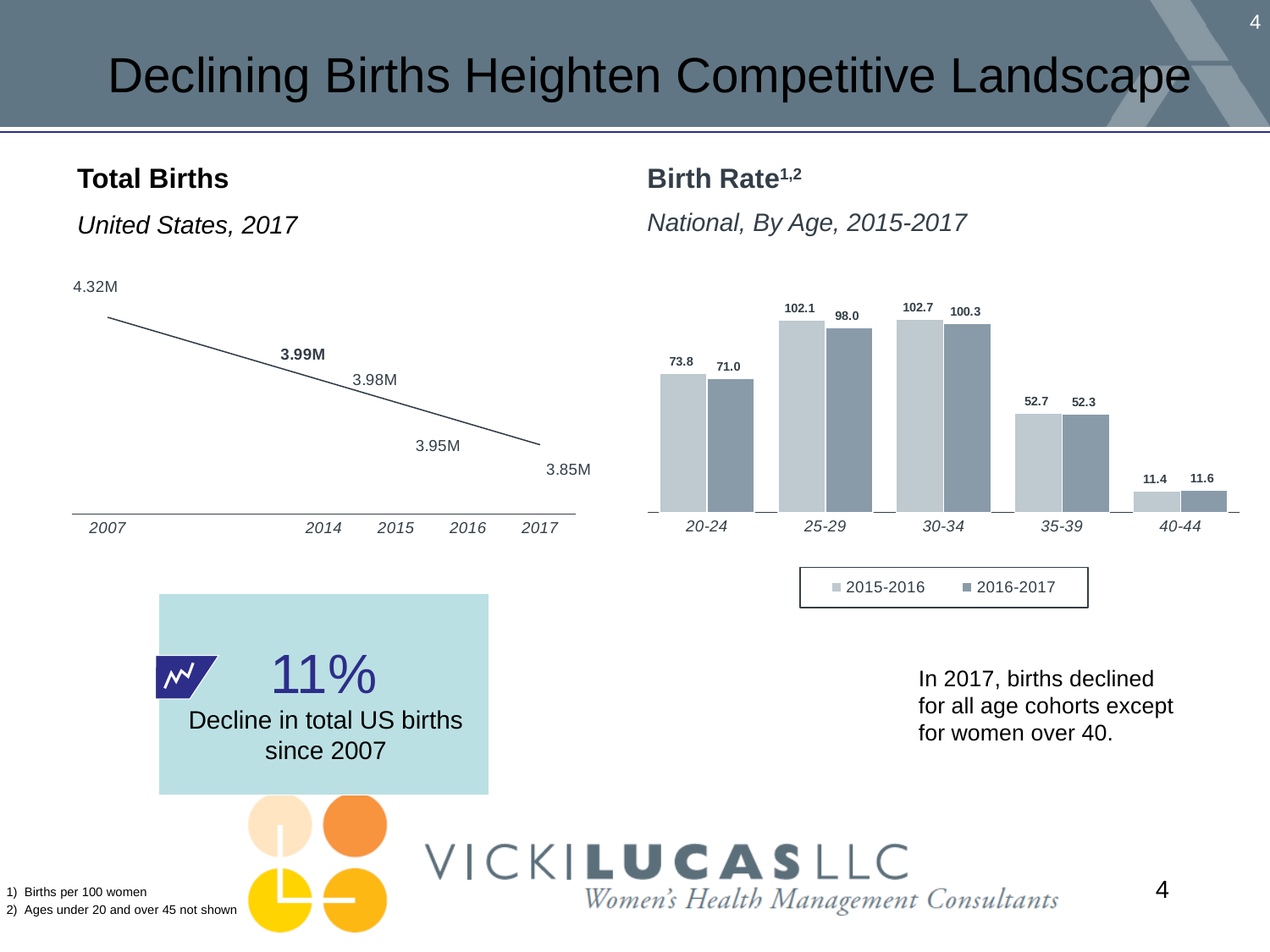
In the Total Births chart, how many years are plotted? 5 In the Total Births chart, do the values rise or fall from 2007 to 2017? fall In the Total Births chart, what was the value for 2007? 4.32M In the Birth Rate chart, how many series does the legend list? 2 In the Birth Rate chart, which age group has the highest 2015-2016 value? 30-34 In the Birth Rate chart, what is the difference between the 2015-2016 and 2016-2017 values for the 20-24 age group? 2.8 What kind of chart is the Birth Rate chart? bar chart In the Birth Rate chart, what is the 2016-2017 value for the 25-29 age group? 98.0 In the Birth Rate chart, which age group has the lowest 2016-2017 value? 40-44 In the Total Births chart, what was the value for 2017? 3.85M In the Birth Rate chart, what is the 2015-2016 value for the 35-39 age group? 52.7 What kind of chart is the Total Births chart? line chart